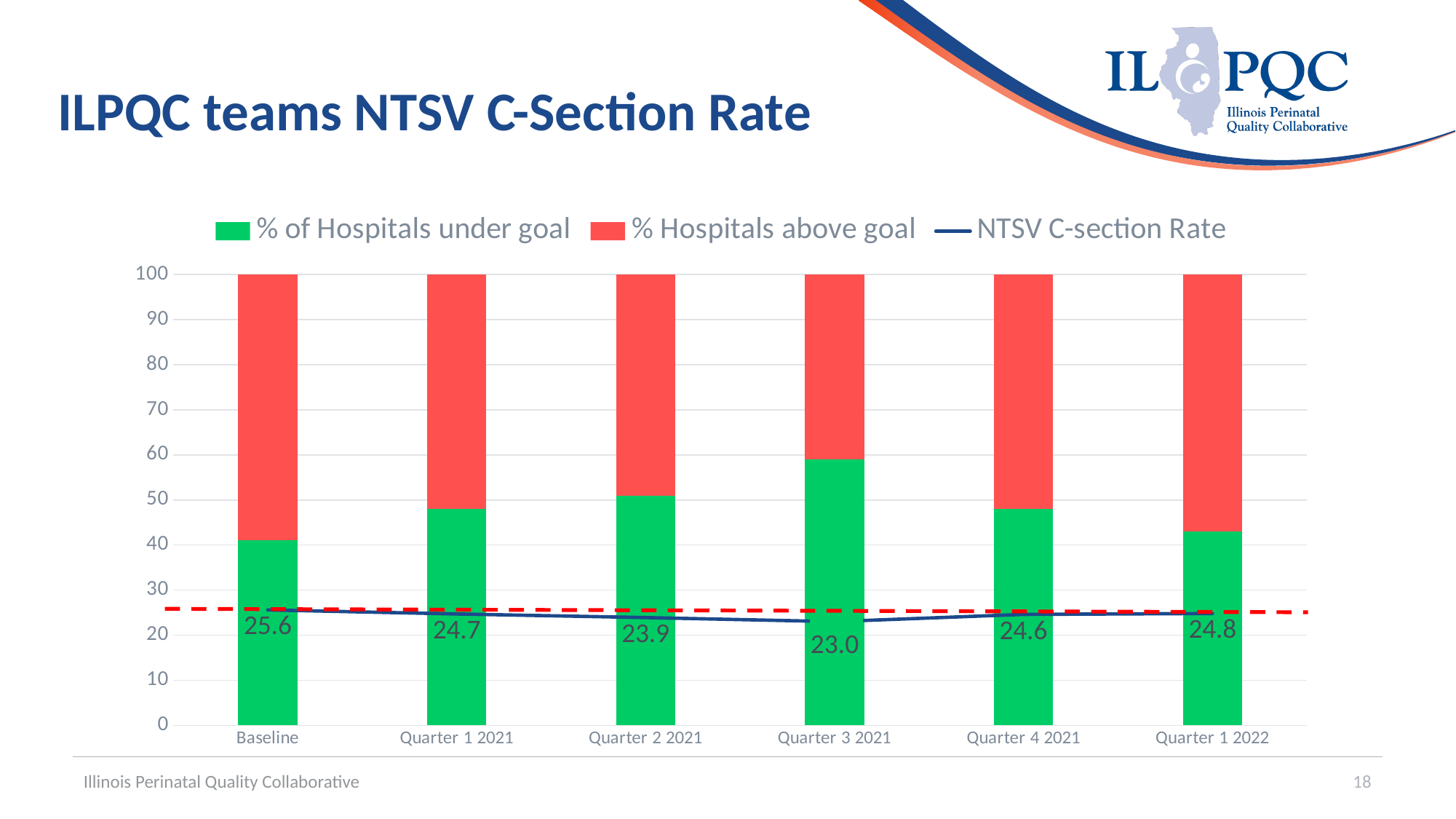
What is the difference between the NTSV C-section Rate at Baseline and in Quarter 3 2021? 2.6 How many series does the legend list? 3 How many periods are shown on the x axis? 6 Which period has the highest NTSV C-section Rate? Baseline What is the NTSV C-section Rate for Quarter 3 2021? 23.0 Does the NTSV C-section Rate rise or fall from Baseline to Quarter 3 2021? fall Which period has the lowest NTSV C-section Rate? Quarter 3 2021 What kind of chart is used to show the % of Hospitals under goal and above goal? bar chart What is the NTSV C-section Rate at Baseline? 25.6 Is the % of Hospitals under goal at Baseline greater or less than 50? less Which has a higher NTSV C-section Rate, Quarter 4 2021 or Quarter 1 2022? Quarter 1 2022 Is the % of Hospitals under goal for Quarter 3 2021 greater or less than 50? greater